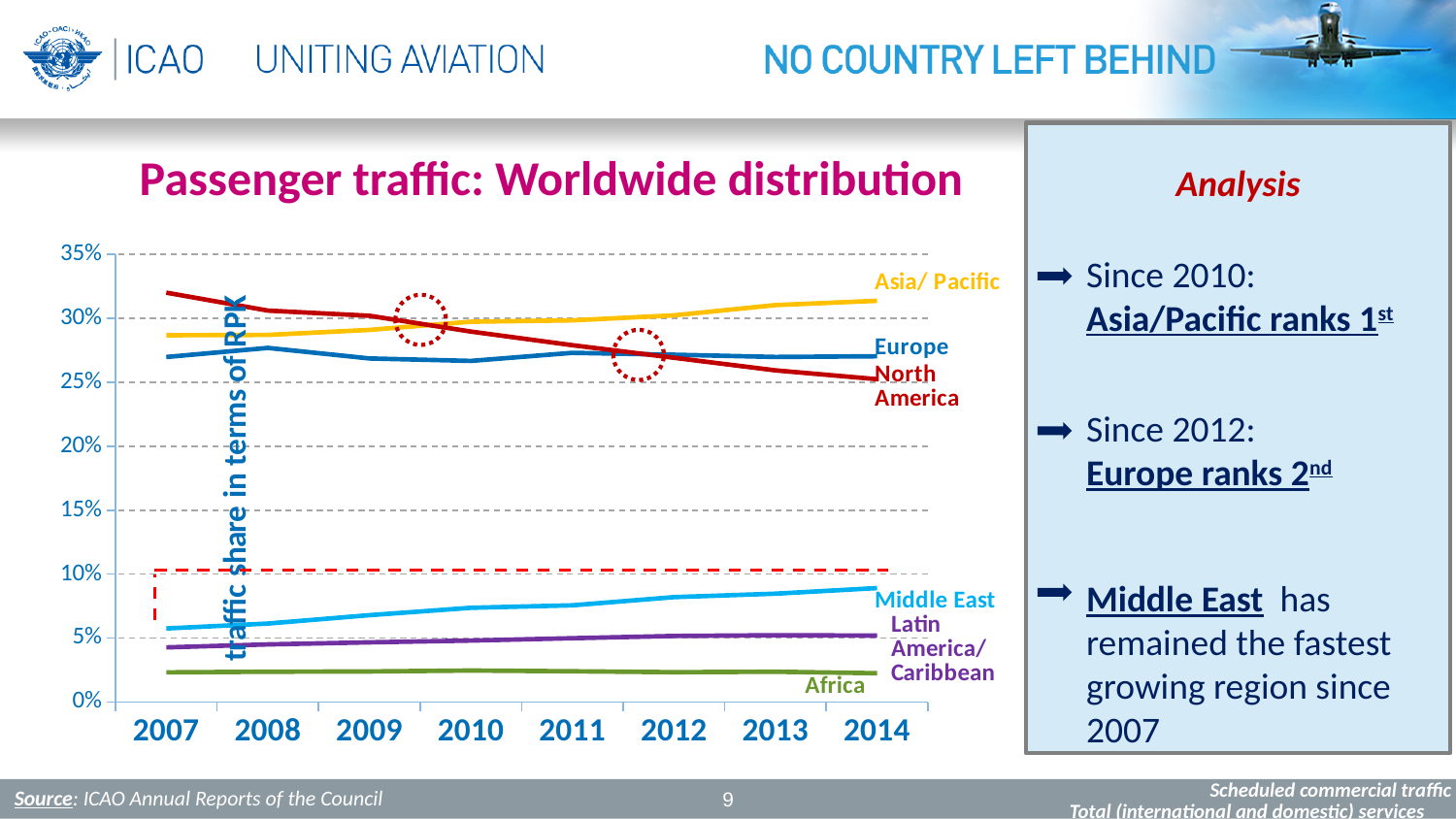
Which region has the lowest traffic share in 2014? Africa Does the traffic share for Asia/Pacific rise or fall from 2007 to 2014? rise Is the value for North America in 2007 greater or less than 30%? greater In 2014, which is larger: the traffic share for Europe or for North America? Europe How many regions (series) are plotted on the chart? 6 What is the title of the chart? Passenger traffic: Worldwide distribution Does the traffic share for North America rise or fall from 2007 to 2014? fall How many years are shown along the x axis of the chart? 8 What kind of chart is shown on the slide? line chart Which region has the highest traffic share in 2007? North America Which region has the highest traffic share in 2014? Asia/Pacific Is the value for Middle East in 2014 greater or less than 10%? less